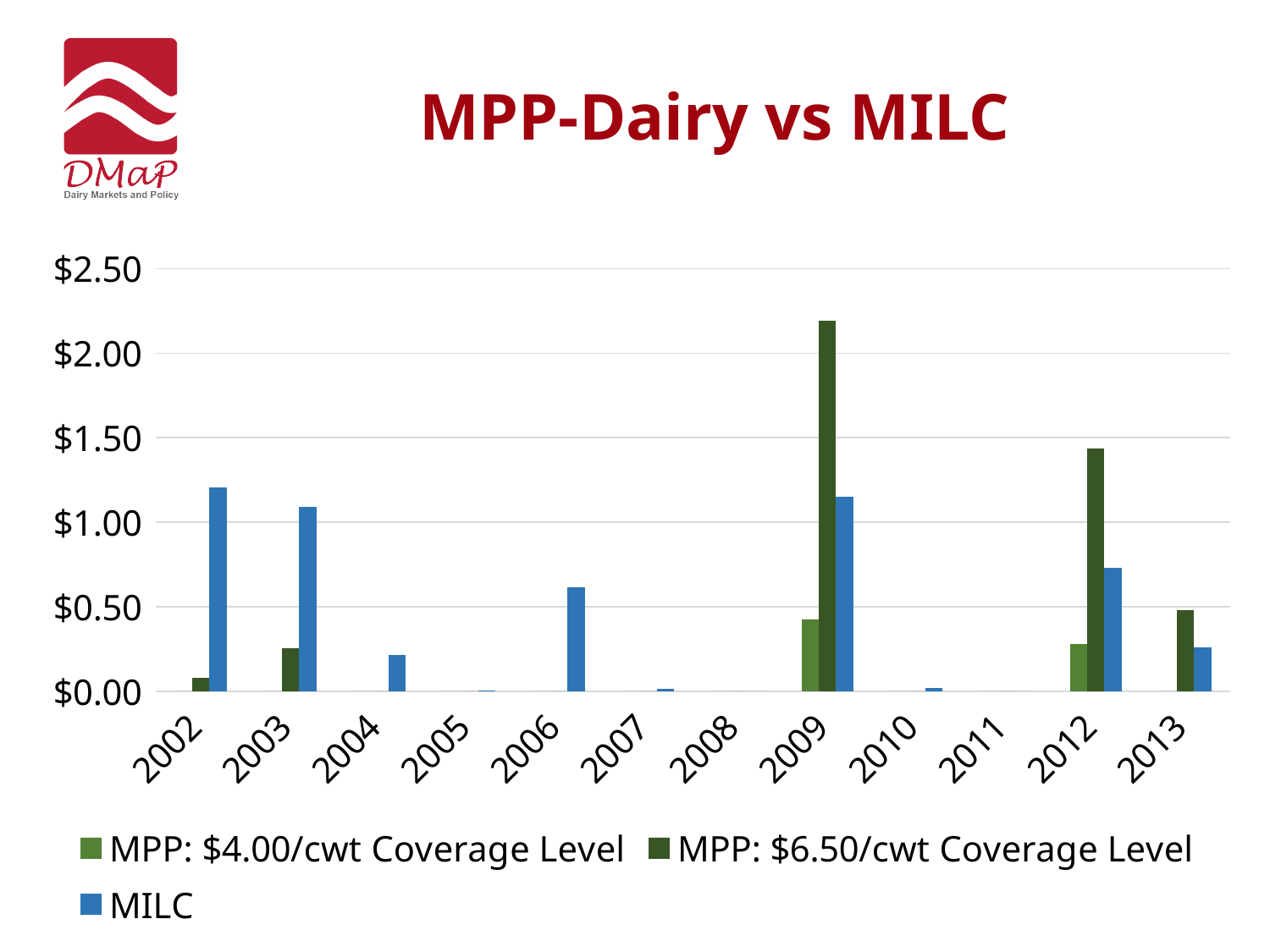
How many years are shown on the x axis? 12 Is the MPP: $6.50/cwt Coverage Level value for 2012 greater or less than $1.50? less What kind of chart is shown on the slide? bar chart How many series does the legend list? 3 In which year is the MPP: $4.00/cwt Coverage Level bar the highest? 2009 In 2012, which is larger: the MPP: $4.00/cwt Coverage Level value or the MILC value? MILC Is the MPP: $6.50/cwt Coverage Level value for 2009 greater or less than $2.00? greater What is the title of the chart? MPP-Dairy vs MILC Is the MILC value for 2006 greater or less than $0.50? greater In which year is the MPP: $6.50/cwt Coverage Level bar the highest? 2009 In 2009, which is larger: the MPP: $6.50/cwt Coverage Level value or the MILC value? MPP: $6.50/cwt Coverage Level